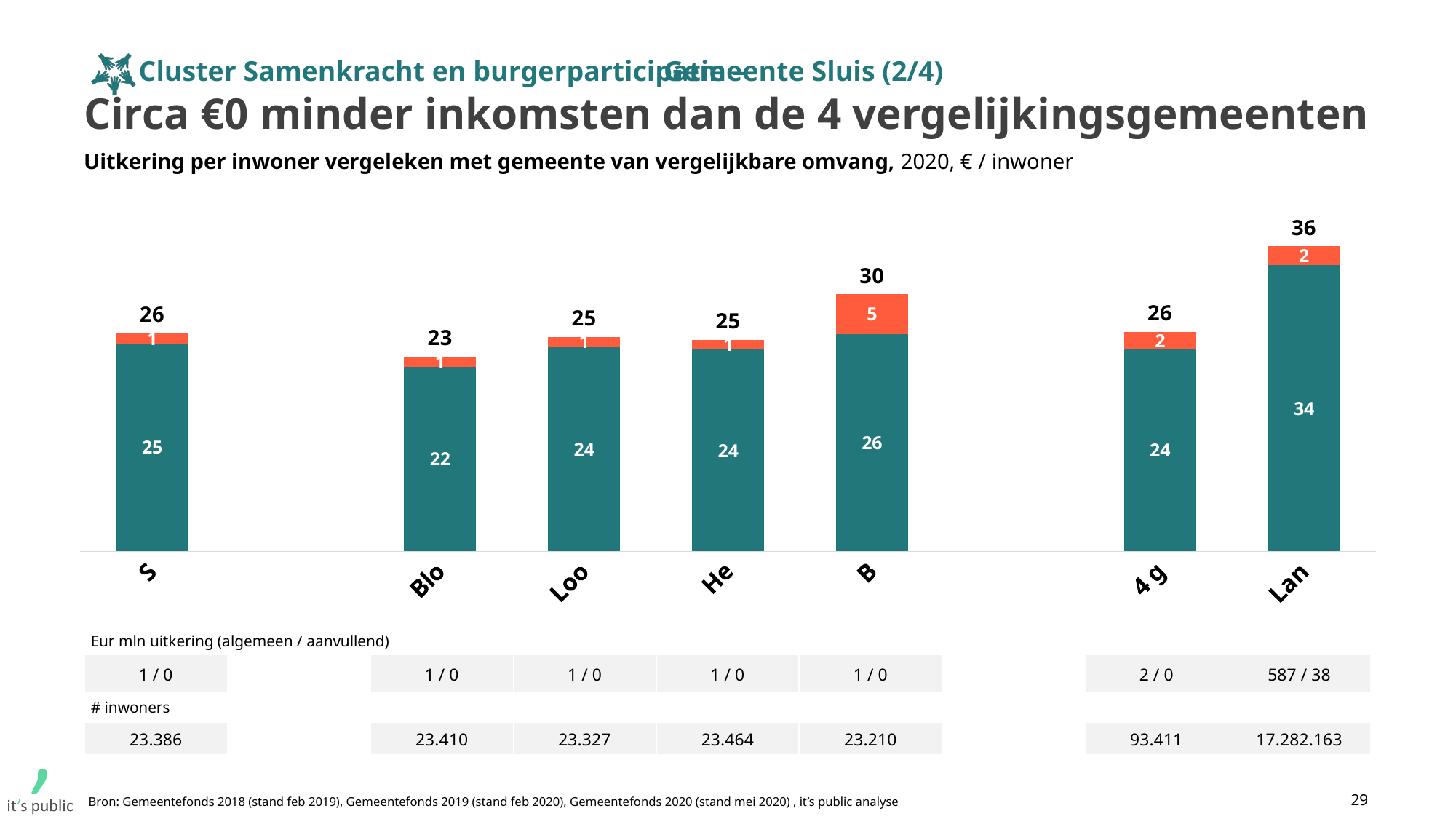
What is the value of the teal (lower) segment of the bar for Lan? 34 What is the value of the teal (lower) segment of the bar for B? 26 What is the total value shown above the bar for Lan? 36 Which has a larger total value, B or 4 g? B Which category has the highest total value? Lan What is the total value shown above the bar for Blo? 23 What kind of chart is shown on the slide? Stacked bar chart How many bars are shown in the chart? 7 Which category has the lowest total value? Blo What is the value of the orange (upper) segment of the bar for B? 5 What is the difference between the total for Lan and the total for S? 10 What is the difference between the orange segment for B and the orange segment for He? 4